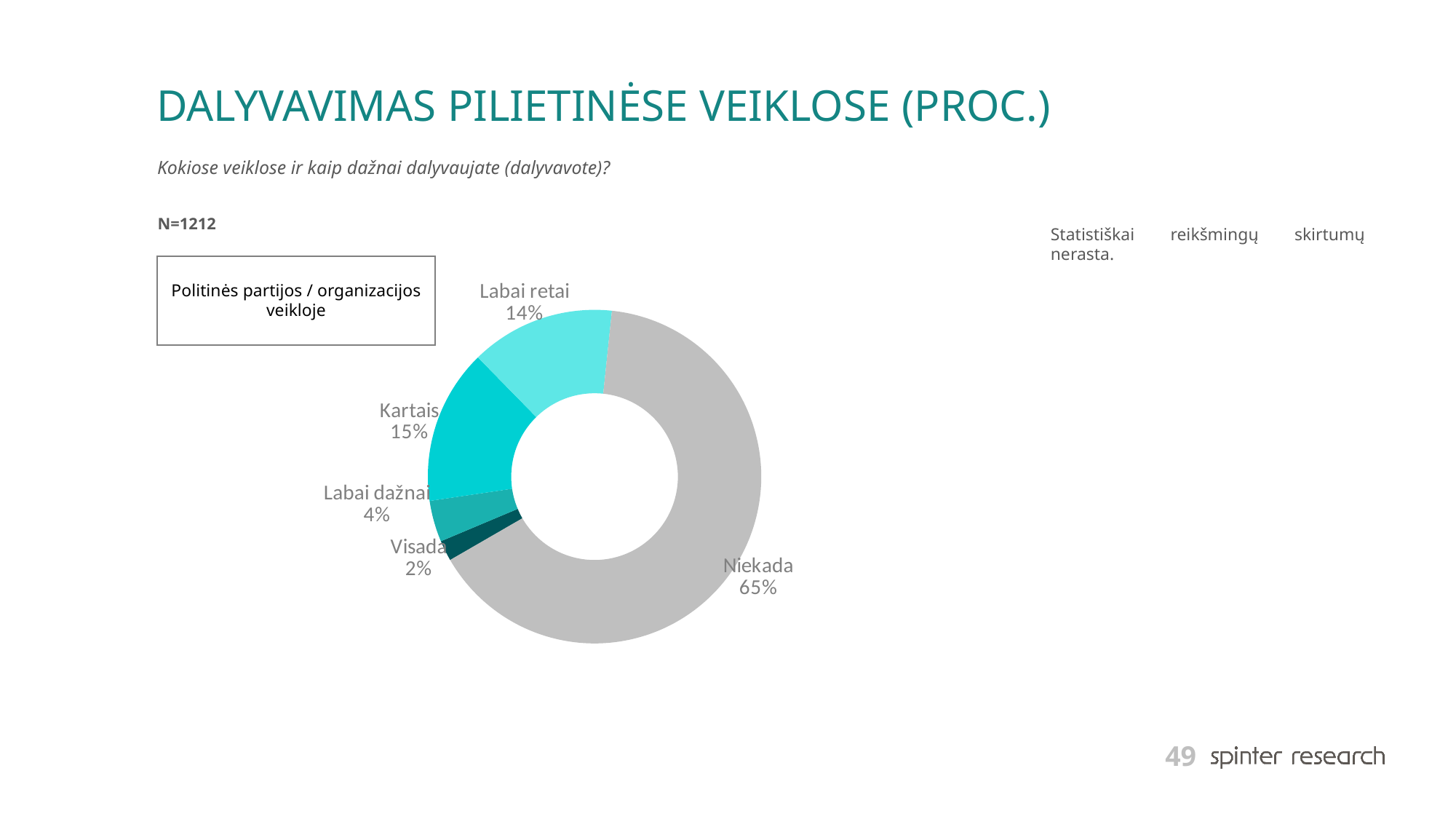
How many categories are shown in the chart? 5 Which category has the smallest share of the chart? Visada What share of respondents answered "Niekada" in the donut chart? 65% What kind of chart is shown on the slide? Donut (pie) chart What is the combined share of "Kartais" and "Labai retai"? 29% Which is larger, the share for "Labai dažnai" or the share for "Visada"? Labai dažnai What is the difference in percentage points between "Niekada" and "Kartais"? 50 What percentage is shown for "Kartais"? 15% What percentage is shown for "Visada"? 2% What percentage is shown for "Labai retai"? 14% Which category has the largest share of the chart? Niekada Which activity does the chart refer to, according to the box on the left? Politinės partijos / organizacijos veikloje